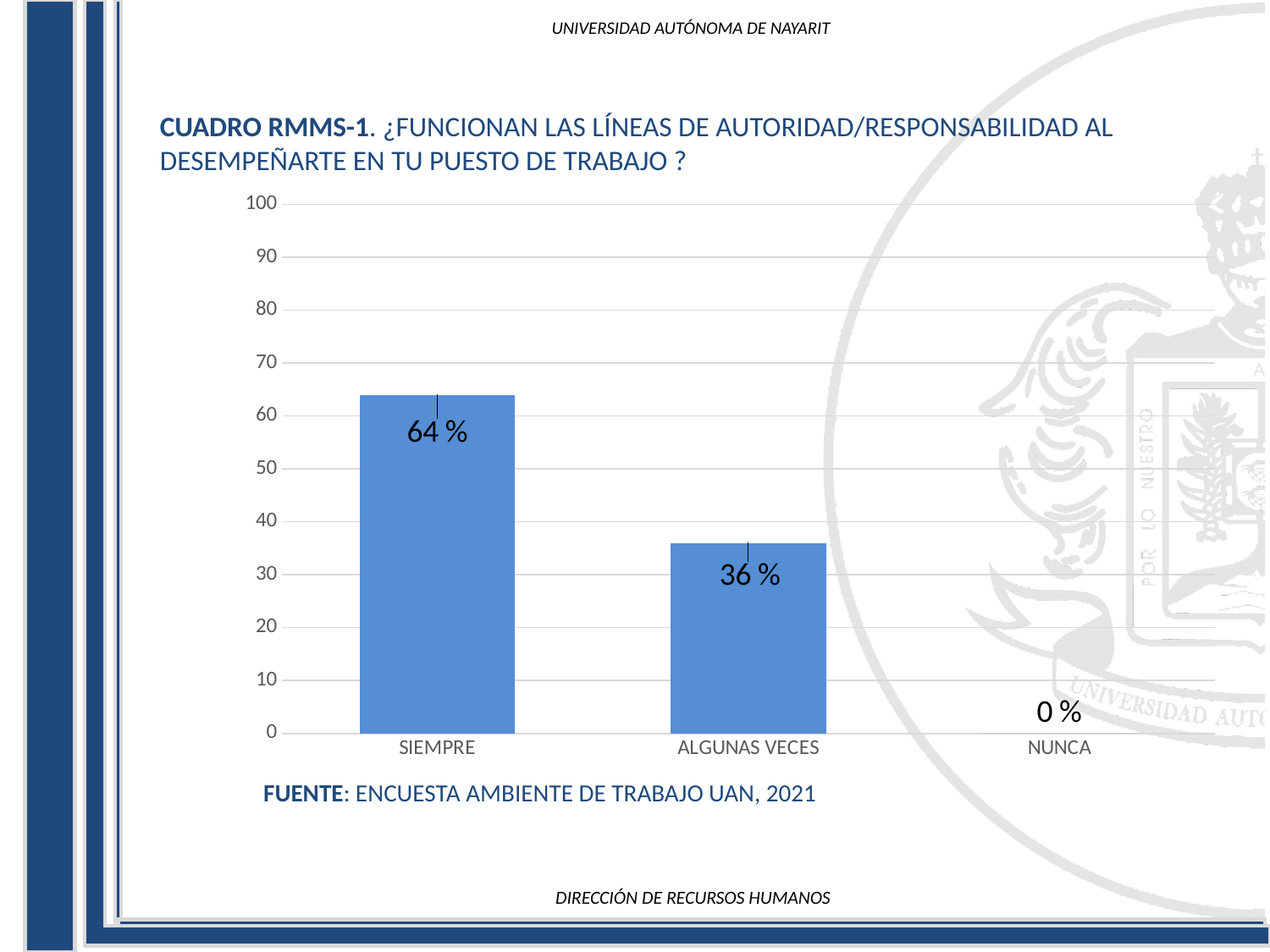
What is the source cited below the chart? ENCUESTA AMBIENTE DE TRABAJO UAN, 2021 What is the value for ALGUNAS VECES? 36 % What is the value for SIEMPRE? 64 % Which is larger, the value for SIEMPRE or the value for ALGUNAS VECES? SIEMPRE How many categories are shown on the x axis? 3 What kind of chart is shown on the slide? bar chart What is the value for NUNCA? 0 % Is the value for ALGUNAS VECES greater or less than 40? less Which category has the highest value? SIEMPRE Which category has the lowest value? NUNCA Is the value for SIEMPRE greater or less than 50? greater What is the difference between the values for SIEMPRE and ALGUNAS VECES? 28 %